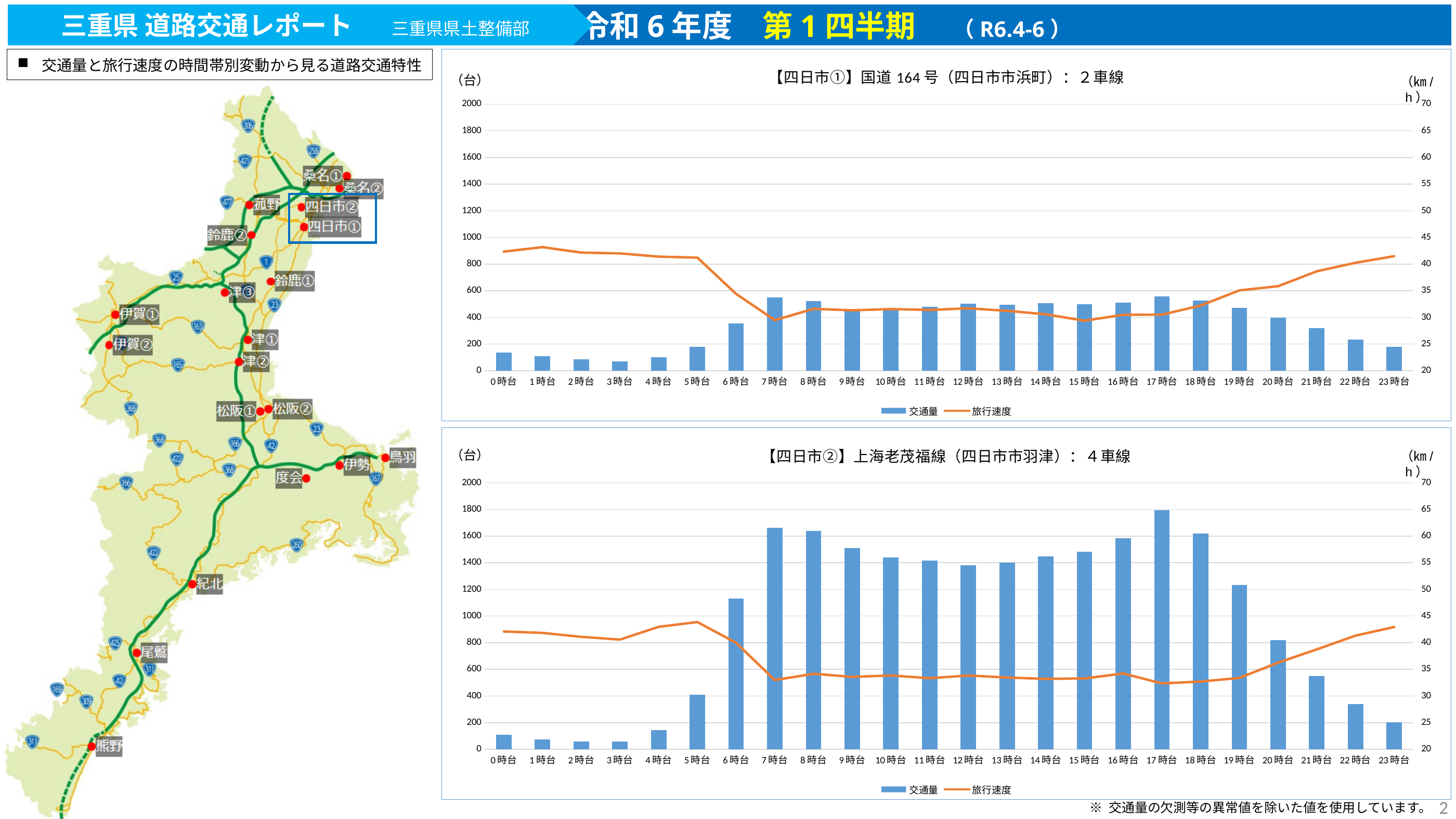
In the bottom chart (【四日市②】上海老茂福線), which time slot has the highest 交通量 bar? 17時台 In the top chart (【四日市①】国道164号), how many time-of-day categories are shown on the x axis? 24 In the bottom chart (【四日市②】上海老茂福線), is the 交通量 value for 21時台 greater or less than 600? less What unit is shown on the right-hand axis of the top chart (【四日市①】国道164号)? km/h In the bottom chart (【四日市②】上海老茂福線), is the 交通量 value for 9時台 greater or less than 1400? greater What kind of chart is the top chart (【四日市①】国道164号)? Combined bar and line chart In the top chart (【四日市①】国道164号), is the 交通量 value for 7時台 greater or less than 400? greater In the bottom chart (【四日市②】上海老茂福線), how many series does the legend list? 2 In the bottom chart (【四日市②】上海老茂福線), do the 交通量 bars rise or fall from 3時台 to 7時台? rise In the top chart (【四日市①】国道164号), does the 旅行速度 line rise or fall from 5時台 to 7時台? fall